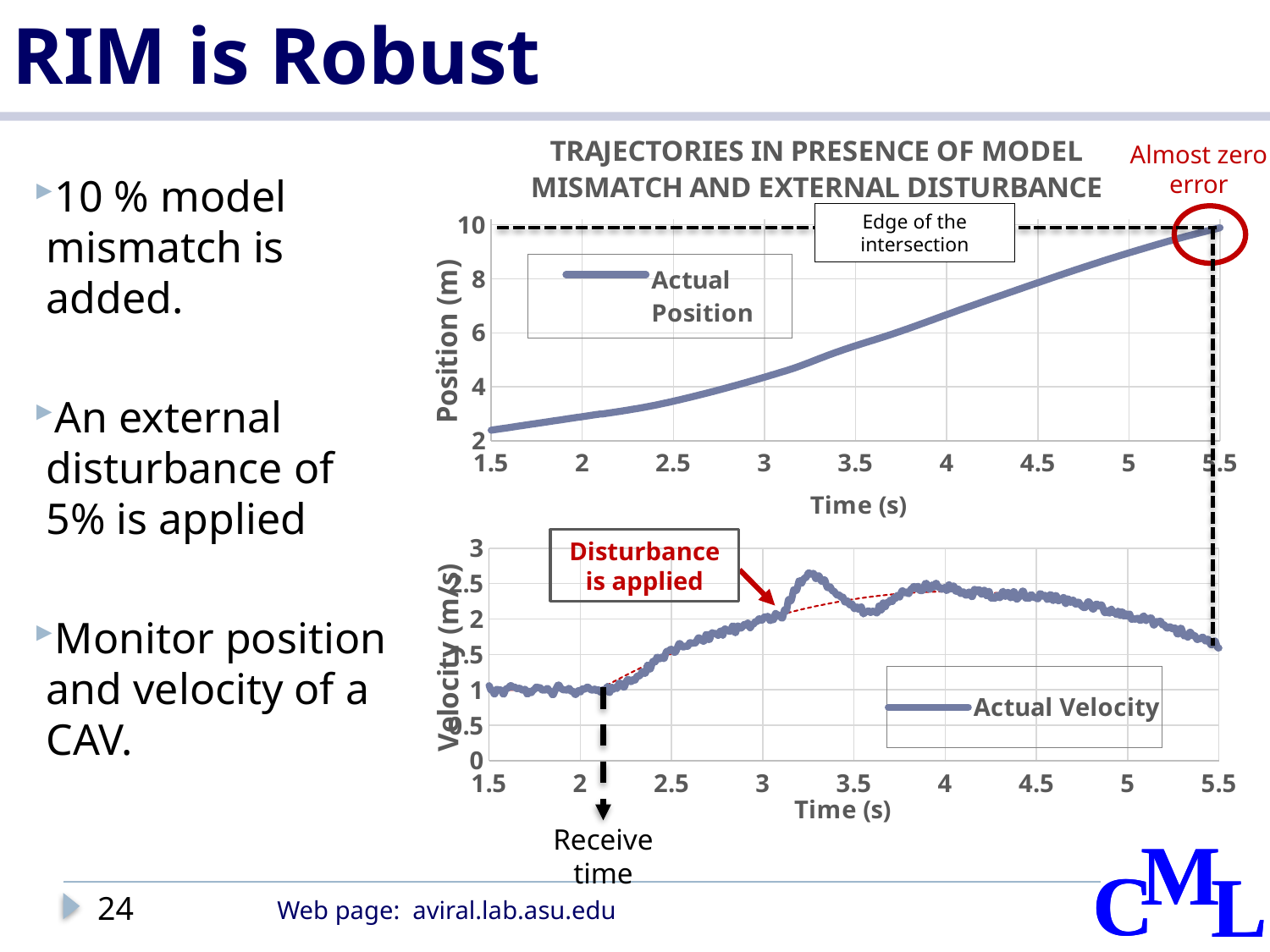
In the bottom chart, is the Actual Velocity at time 4.5 s greater or less than 2 m/s? greater In the top chart, is the Actual Position at time 4 s greater or less than 6 m? greater In the top chart, is the Actual Position at time 1.5 s greater or less than 2 m? greater What is the y-axis label of the bottom chart? Velocity (m/s) What kind of chart is the top chart showing Actual Position? line chart How many series does the legend of the bottom chart list? 1 What kind of chart is the bottom chart showing Actual Velocity? line chart In the top chart, does the Actual Position rise or fall as time increases from 1.5 s to 5.5 s? rise What is the title shown above the charts? TRAJECTORIES IN PRESENCE OF MODEL MISMATCH AND EXTERNAL DISTURBANCE